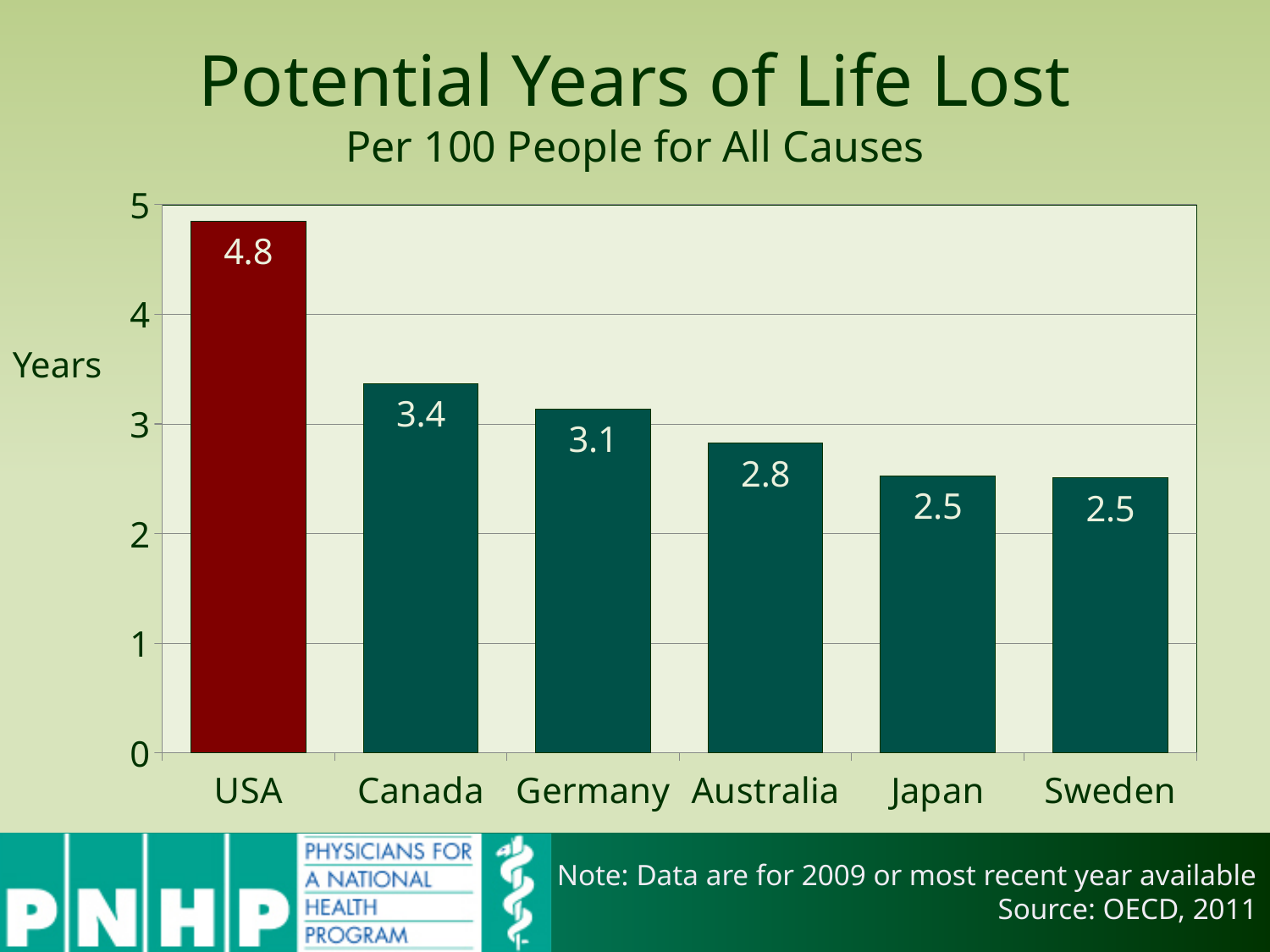
Do the values generally rise or fall from left to right across the countries? Fall What is the value for Germany? 3.1 Which country has the highest potential years of life lost? USA What kind of chart is shown on the slide? Bar chart What is the value for the USA? 4.8 What is the difference between the values for Canada and Japan? 0.9 Which bar is coloured differently from the others? USA Which is larger, the value for Canada or the value for Australia? Canada What is the difference between the values for the USA and Canada? 1.4 How many countries are shown in the chart? 6 Is the value for Germany greater or less than 3? greater What is the value for Australia? 2.8